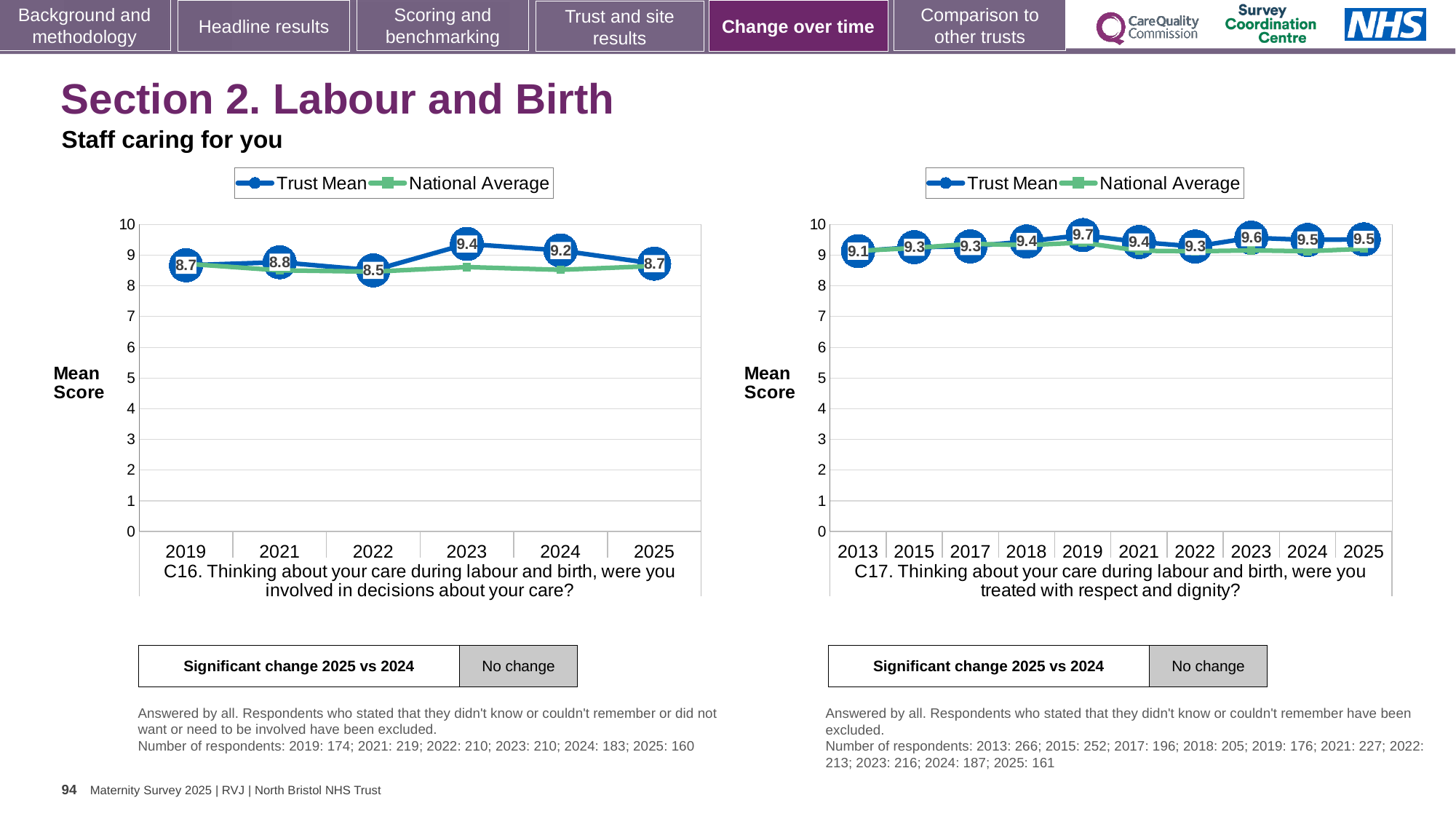
In the C17 chart on the right, what is the Trust Mean score for 2019? 9.7 In the C16 chart on the left, which year has the highest Trust Mean score? 2023 In the C16 chart on the left, which year has the lowest Trust Mean score? 2022 In the C17 chart on the right, which year has the lowest Trust Mean score? 2013 In the C16 chart on the left, what is the difference between the Trust Mean scores for 2023 and 2022? 0.9 In the C16 chart on the left, what is the Trust Mean score for 2022? 8.5 In the C16 chart on the left, what is the Trust Mean score for 2023? 9.4 In the C16 chart on the left, how many years are plotted on the x axis? 6 What kind of chart is the C16 chart on the left? Line chart In the C17 chart on the right, is the Trust Mean score for 2023 larger or smaller than the score for 2022? larger In the C17 chart on the right, how many years are plotted on the x axis? 10 How many series does the legend of the C17 chart on the right list? 2